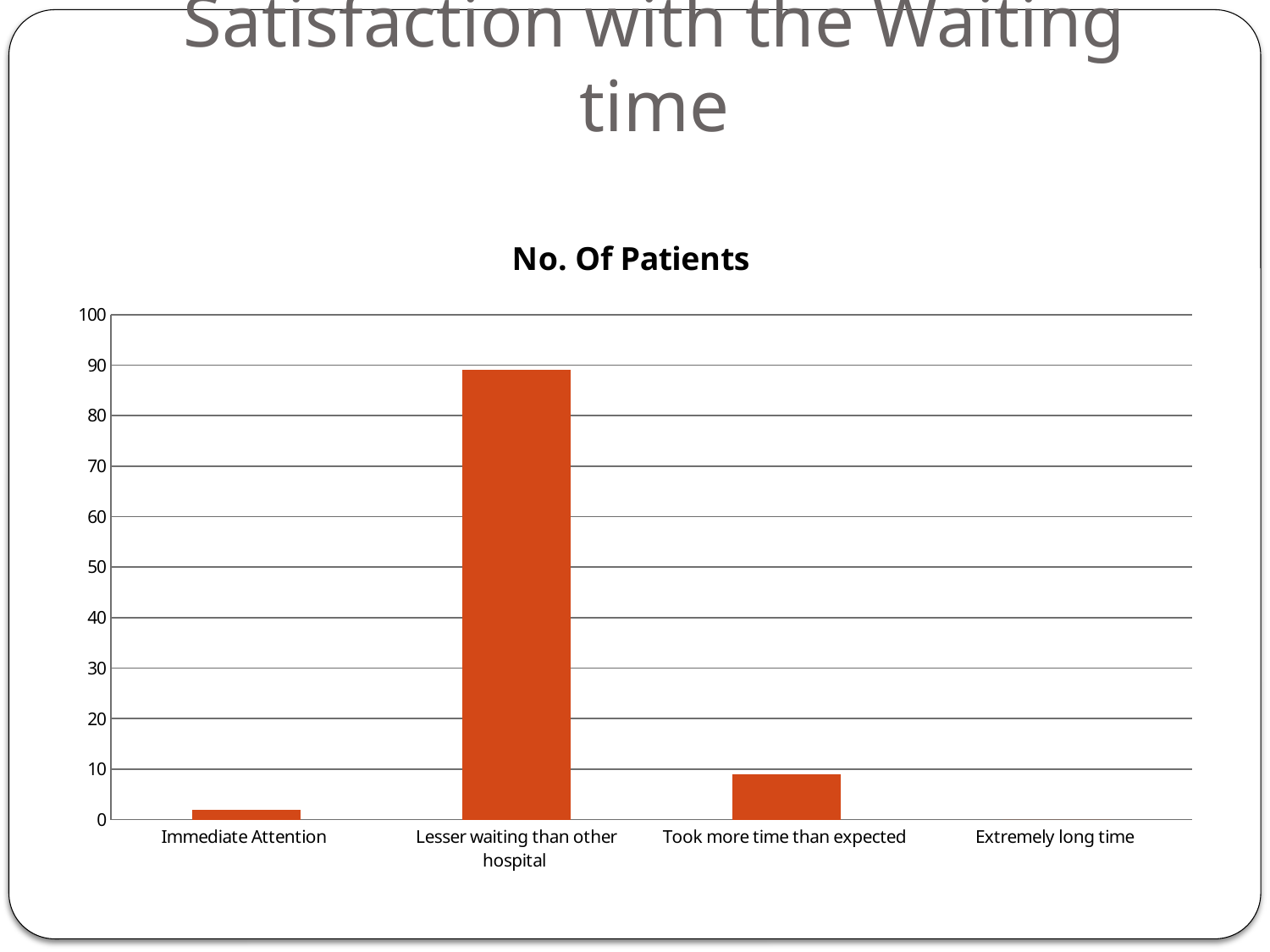
What is the title of the chart? No. Of Patients Which is larger, the value for Lesser waiting than other hospital or the value for Took more time than expected? Lesser waiting than other hospital Is the value for Immediate Attention greater or less than 10? less What type of chart is shown on the slide? bar chart Which category has the lowest number of patients? Extremely long time What is the maximum value shown on the vertical axis of the chart? 100 Which is larger, the value for Took more time than expected or the value for Immediate Attention? Took more time than expected Is the value for Lesser waiting than other hospital greater or less than 80? greater How many categories are shown on the x axis of the chart? 4 Which category has the highest number of patients? Lesser waiting than other hospital